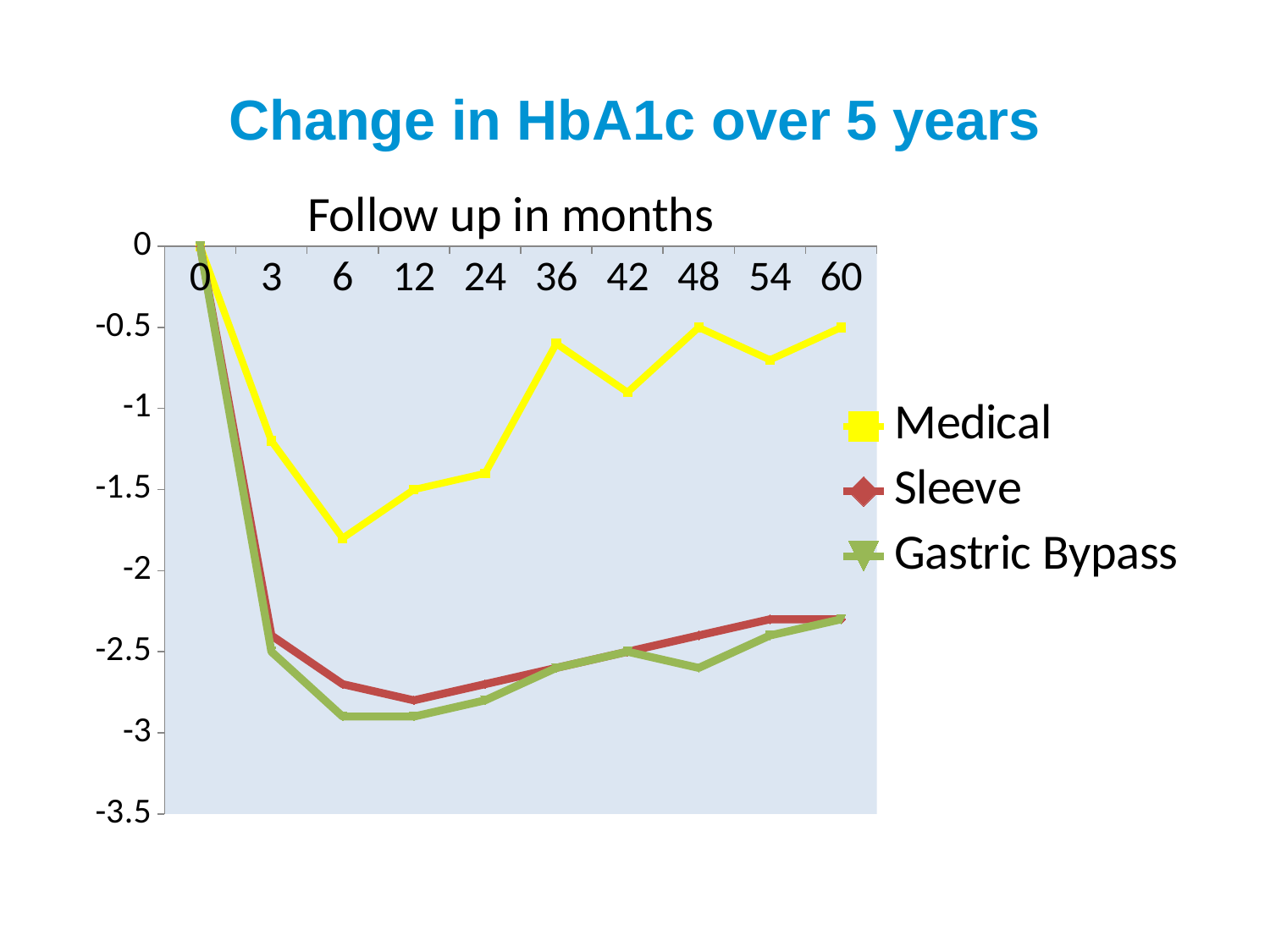
Is the value for Medical at 6 months greater or less than -1.5? less Is the value for Gastric Bypass at 6 months greater or less than -2.5? less What is the value for Medical at 0 months? 0 Is the value for Medical at 36 months greater or less than -1? greater How many series does the legend list? 3 What is the value for Medical at 12 months? -1.5 What kind of chart is shown on the slide? line chart How many follow-up time points are shown on the x axis? 10 Which series has the highest value at 24 months? Medical At 48 months, which is larger, the value for Sleeve or the value for Gastric Bypass? Sleeve Which series has the lowest value at 6 months? Gastric Bypass What is the value for Medical at 60 months? -0.5